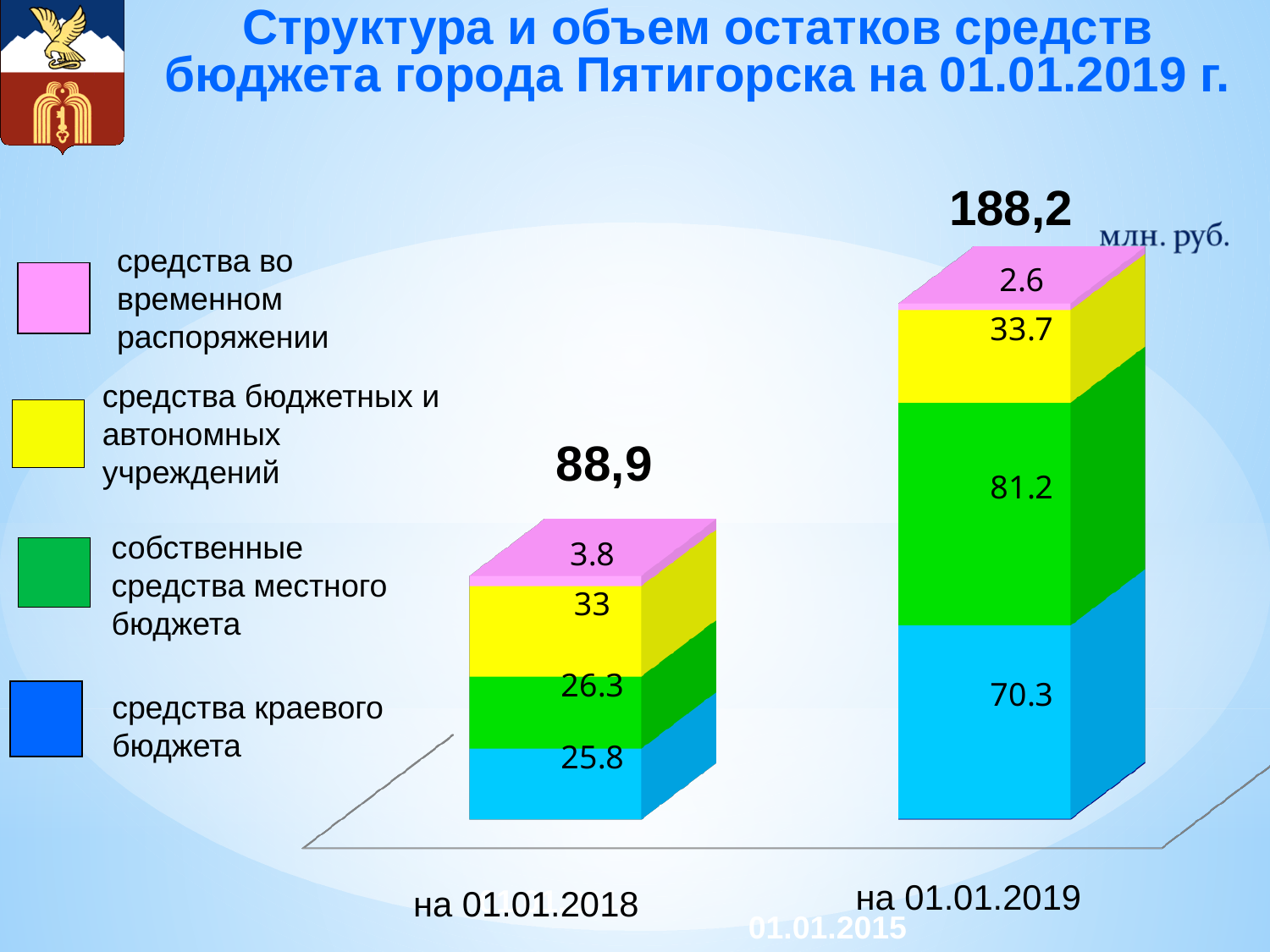
What is the value of средства бюджетных и автономных учреждений for на 01.01.2018? 33 What is the total shown for the на 01.01.2018 bar? 88,9 What is the value of средства во временном распоряжении for на 01.01.2019? 2.6 Which is larger: средства во временном распоряжении for на 01.01.2018 or for на 01.01.2019? на 01.01.2018 What is the difference between средства краевого бюджета for на 01.01.2019 and на 01.01.2018? 44.5 How many series does the legend list? 4 What is the value of средства краевого бюджета for на 01.01.2019? 70.3 What is the value of собственные средства местного бюджета for на 01.01.2018? 26.3 Which segment is the smallest in the на 01.01.2018 bar? средства во временном распоряжении Which segment is the largest in the на 01.01.2019 bar? собственные средства местного бюджета What is the total shown for the на 01.01.2019 bar? 188,2 What kind of chart is shown on the slide? stacked bar chart